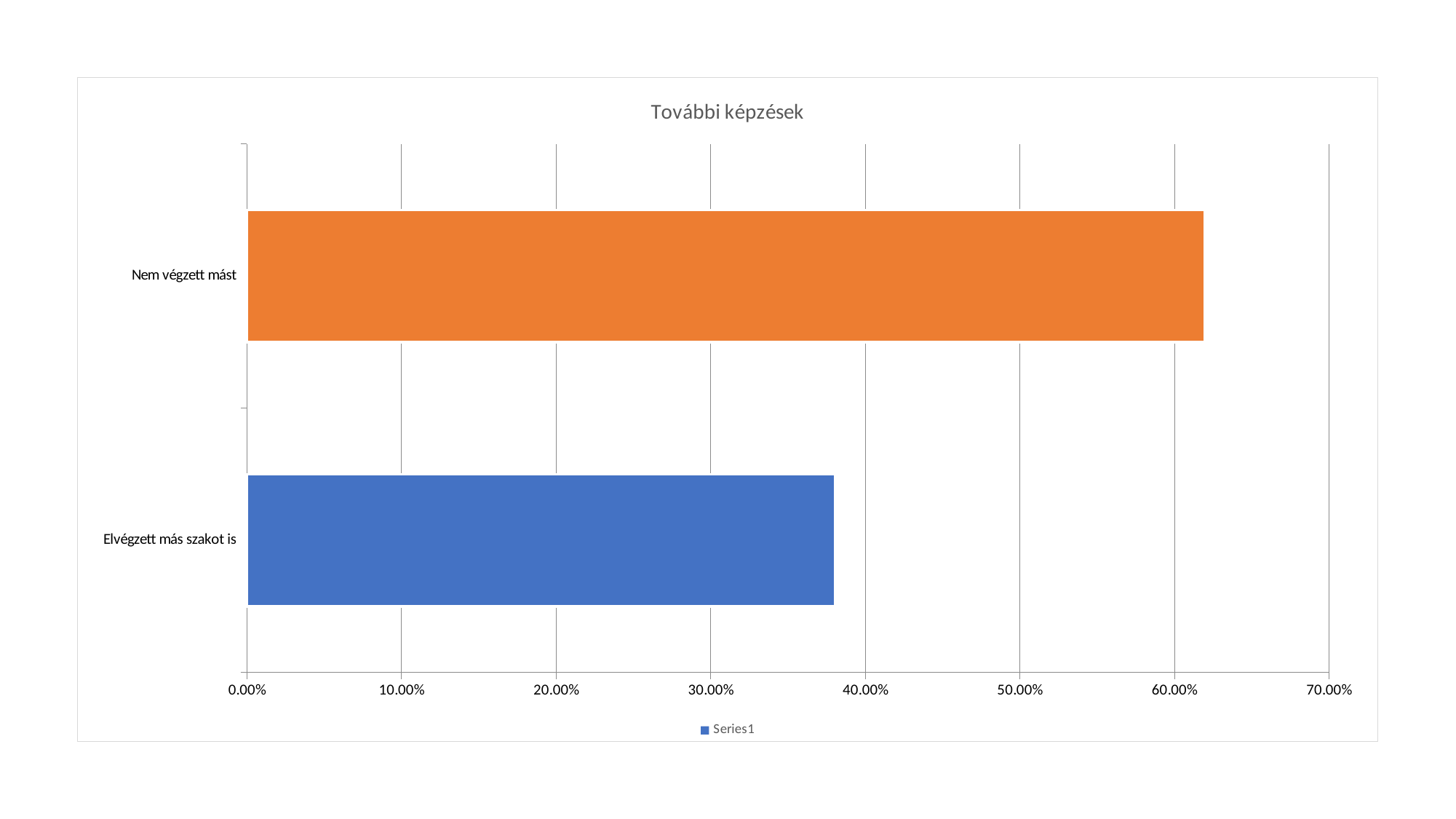
What is the title of the chart? További képzések What is the name of the series listed in the legend? Series1 What kind of chart is shown on the slide? bar chart Which category has the highest value? Nem végzett mást Is the value for Elvégzett más szakot is greater or less than 40.00%? less Is the value for Nem végzett mást greater or less than 60.00%? greater Is the value for Nem végzett mást greater or less than 70.00%? less How many series does the legend list? 1 Which is larger, the value for Nem végzett mást or the value for Elvégzett más szakot is? Nem végzett mást How many categories does the chart show? 2 Which category has the lowest value? Elvégzett más szakot is